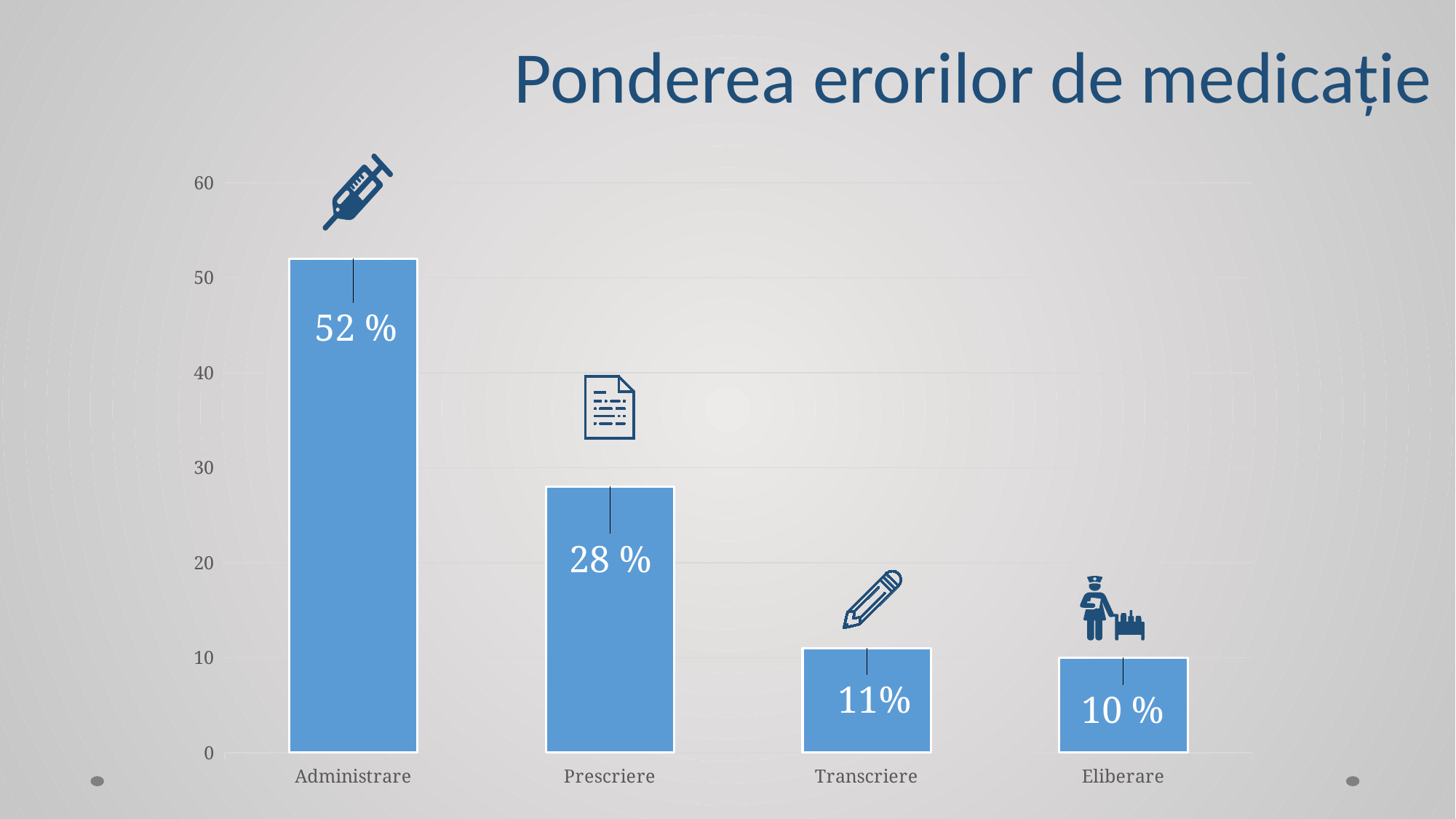
What kind of chart is shown on the slide? bar chart What is the value for Eliberare? 10 % Is the value for Administrare greater or less than 50? greater What is the value for Administrare? 52 % What is the title of the chart? Ponderea erorilor de medicație What is the difference between the values for Administrare and Prescriere? 24 % What is the value for Prescriere? 28 % What is the value for Transcriere? 11% Which is larger, the value for Prescriere or the value for Transcriere? Prescriere How many categories are shown on the x axis? 4 Which category has the highest value? Administrare Which category has the lowest value? Eliberare